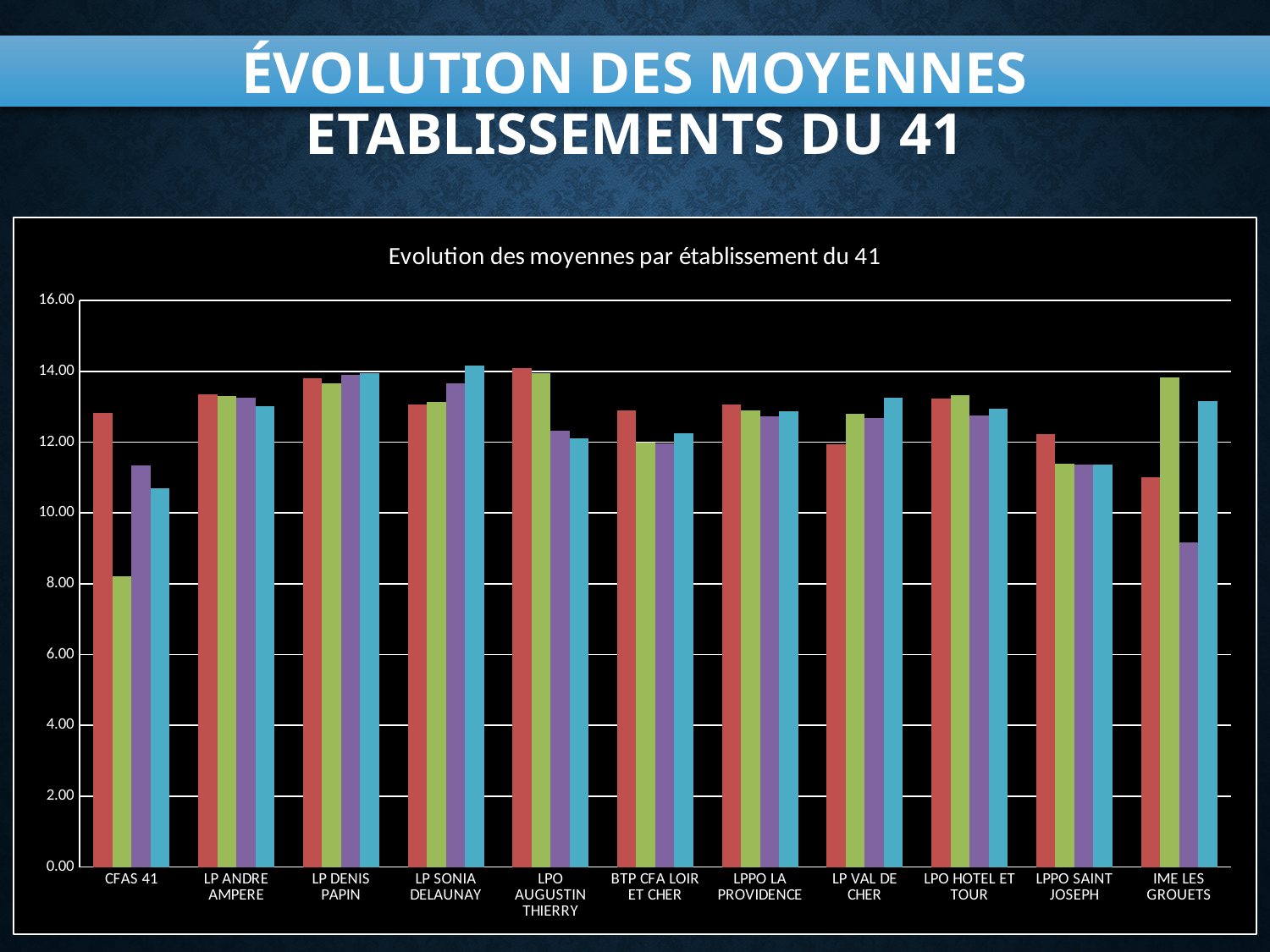
For CFAS 41, which bar is larger: the red bar or the green bar? the red bar Is the value of the blue bar for LP DENIS PAPIN greater or less than 12.00? greater Is the value of the green bar for IME LES GROUETS greater or less than 12.00? greater What is the title printed inside the chart area? Evolution des moyennes par établissement du 41 How many establishments (categories) are shown on the x axis of the chart? 11 What is the highest value shown on the vertical axis of the chart? 16.00 What kind of chart is shown on the slide? bar chart Is the value of the green bar for CFAS 41 greater or less than 10.00? less For IME LES GROUETS, which bar is larger: the green bar or the purple bar? the green bar How many bars are plotted for each establishment in the chart? 4